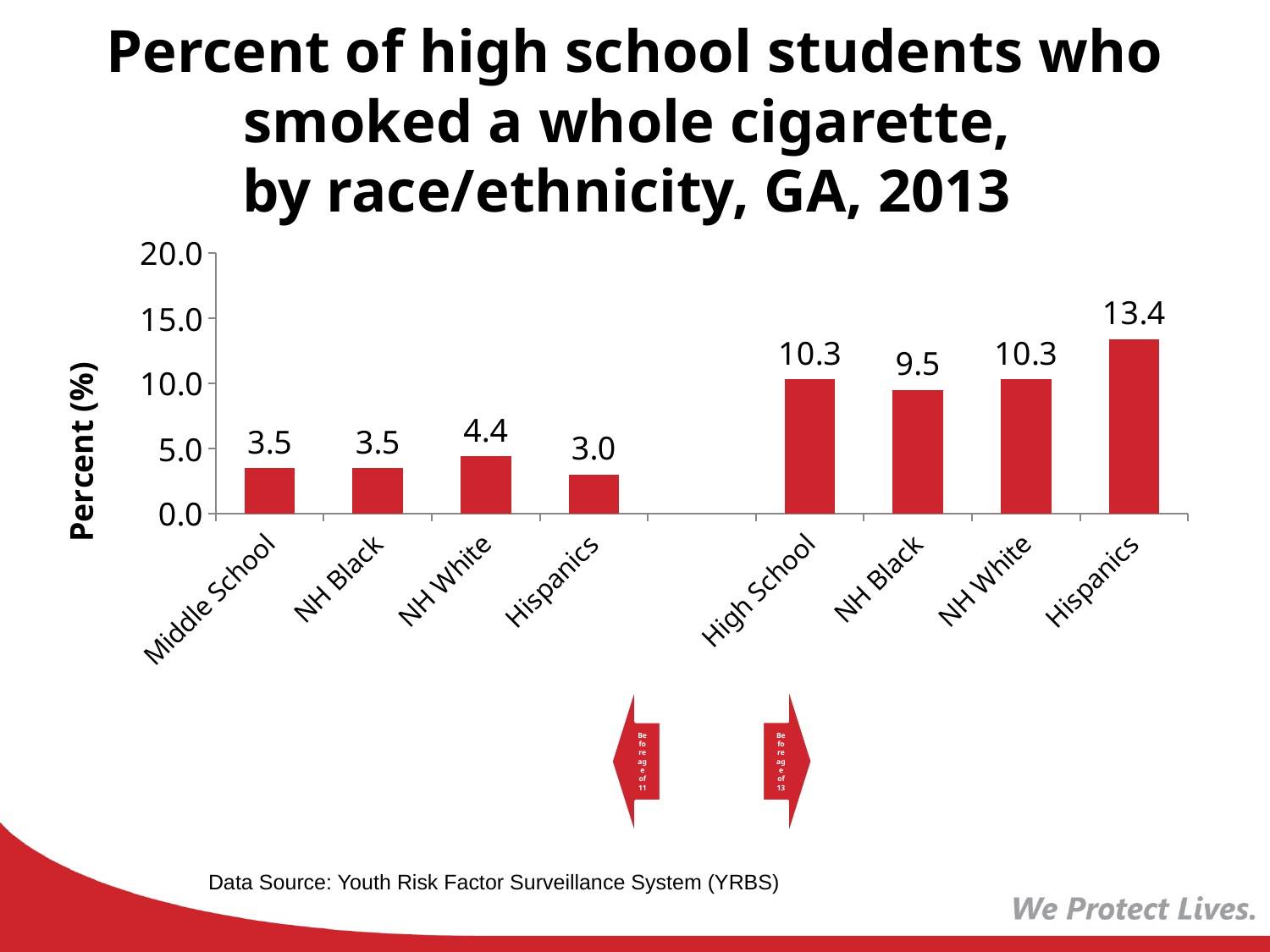
What is the difference between the Hispanics bar in the high school group and the Hispanics bar in the middle school group? 10.4 What is the value for Middle School? 3.5 Which is larger, the NH Black bar in the high school group or the NH White bar in the high school group? NH White How many bars are plotted on the chart? 8 What is the difference between High School and Middle School? 6.8 Which category has the lowest value? Hispanics (middle school group) What is the value for High School? 10.3 What kind of chart is shown on the slide? Bar chart What is the value for the Hispanics bar in the high school group on the right side of the chart? 13.4 Which category has the highest value? Hispanics (high school group) What is the value for the NH White bar in the middle school group on the left side of the chart? 4.4 What is the label on the vertical axis? Percent (%)